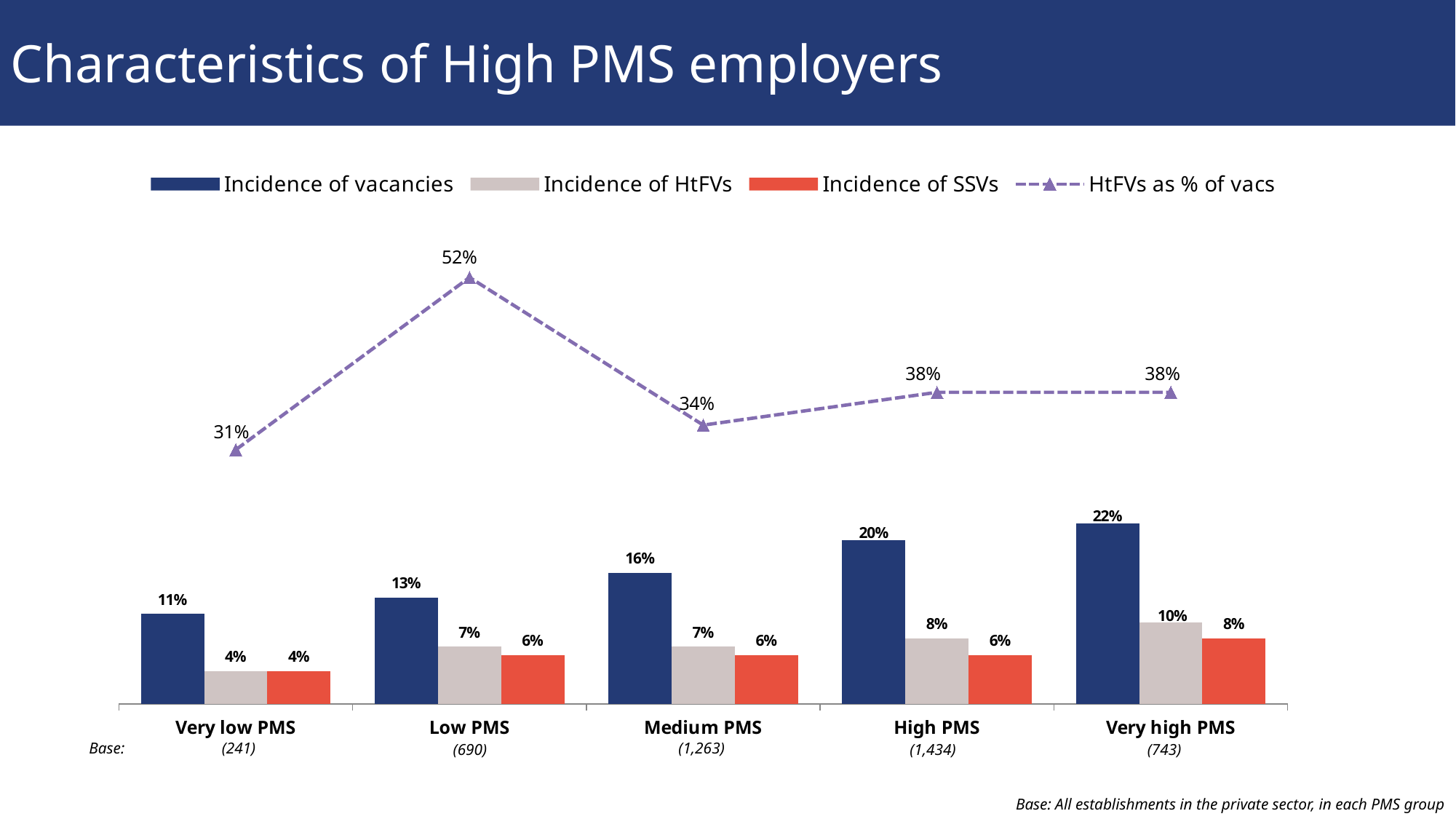
Which PMS group has the lowest HtFVs as % of vacs? Very low PMS How many series does the legend list? 4 What is the Incidence of vacancies for Very high PMS? 22% What is the Incidence of SSVs for Medium PMS? 6% Which PMS group has the highest Incidence of vacancies? Very high PMS What is the base (number of establishments) for the Medium PMS group? 1,263 What is the HtFVs as % of vacs value for Low PMS? 52% What is the difference between the Incidence of vacancies for High PMS and Very low PMS? 9% Does the Incidence of vacancies rise or fall from Very low PMS to Very high PMS? Rise What kind of chart is this? Combined bar and line chart How many PMS groups are shown on the x axis? 5 Which is larger: the Incidence of HtFVs for Very high PMS or for High PMS? Very high PMS